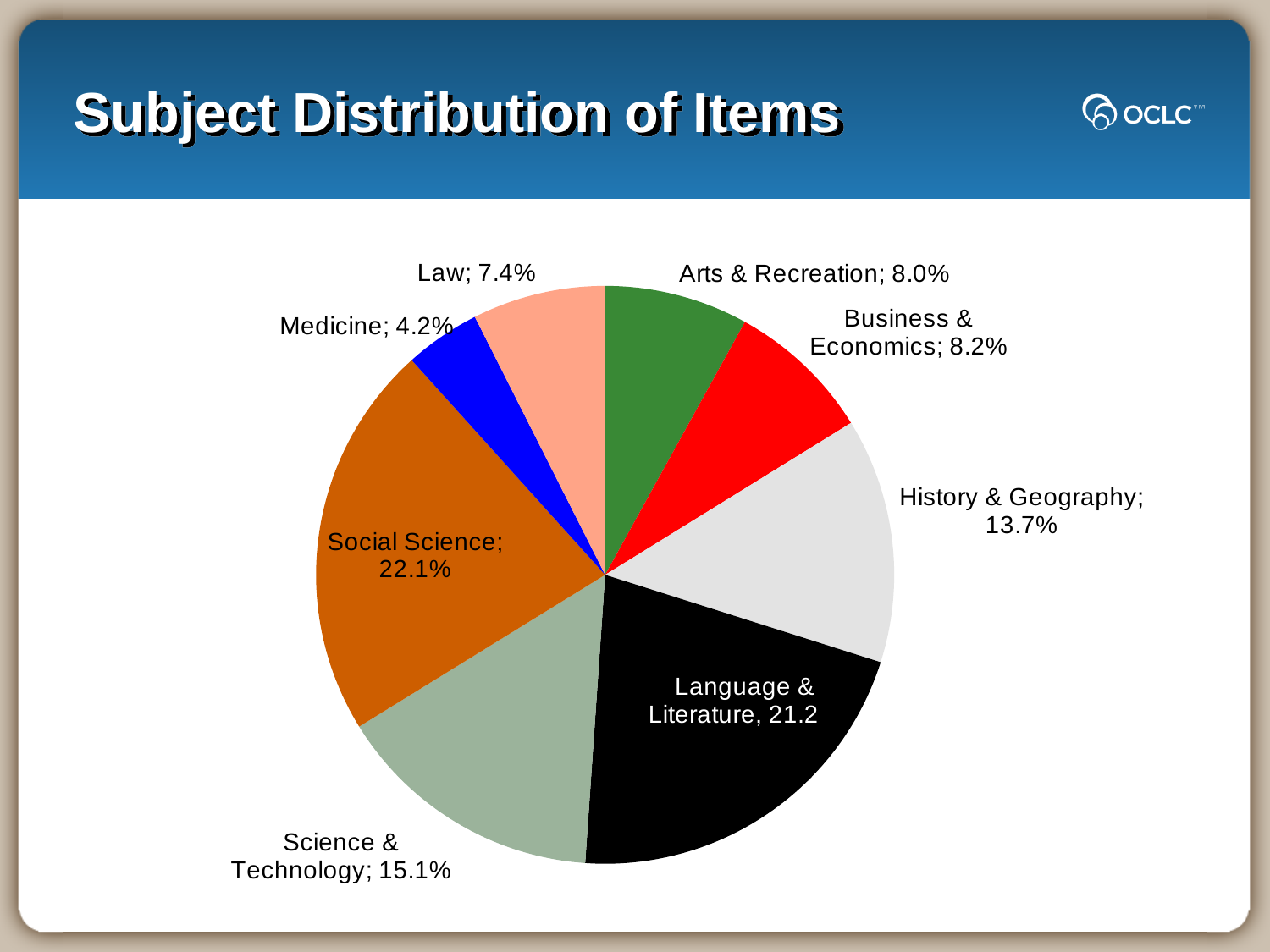
What kind of chart is shown on the slide? Pie chart Which subject has the largest share of items? Social Science How many percentage points larger is Social Science than Science & Technology? 7.0 What share of items is Social Science? 22.1% What is the difference between History & Geography and Law? 6.3 percentage points How many subject categories are shown in the pie chart? 8 What share of items is Medicine? 4.2% Which subject has the smallest share of items? Medicine What value is shown for Language & Literature? 21.2 What percentage of items is History & Geography? 13.7% What is the title of the slide? Subject Distribution of Items Which is larger, Business & Economics or Arts & Recreation? Business & Economics